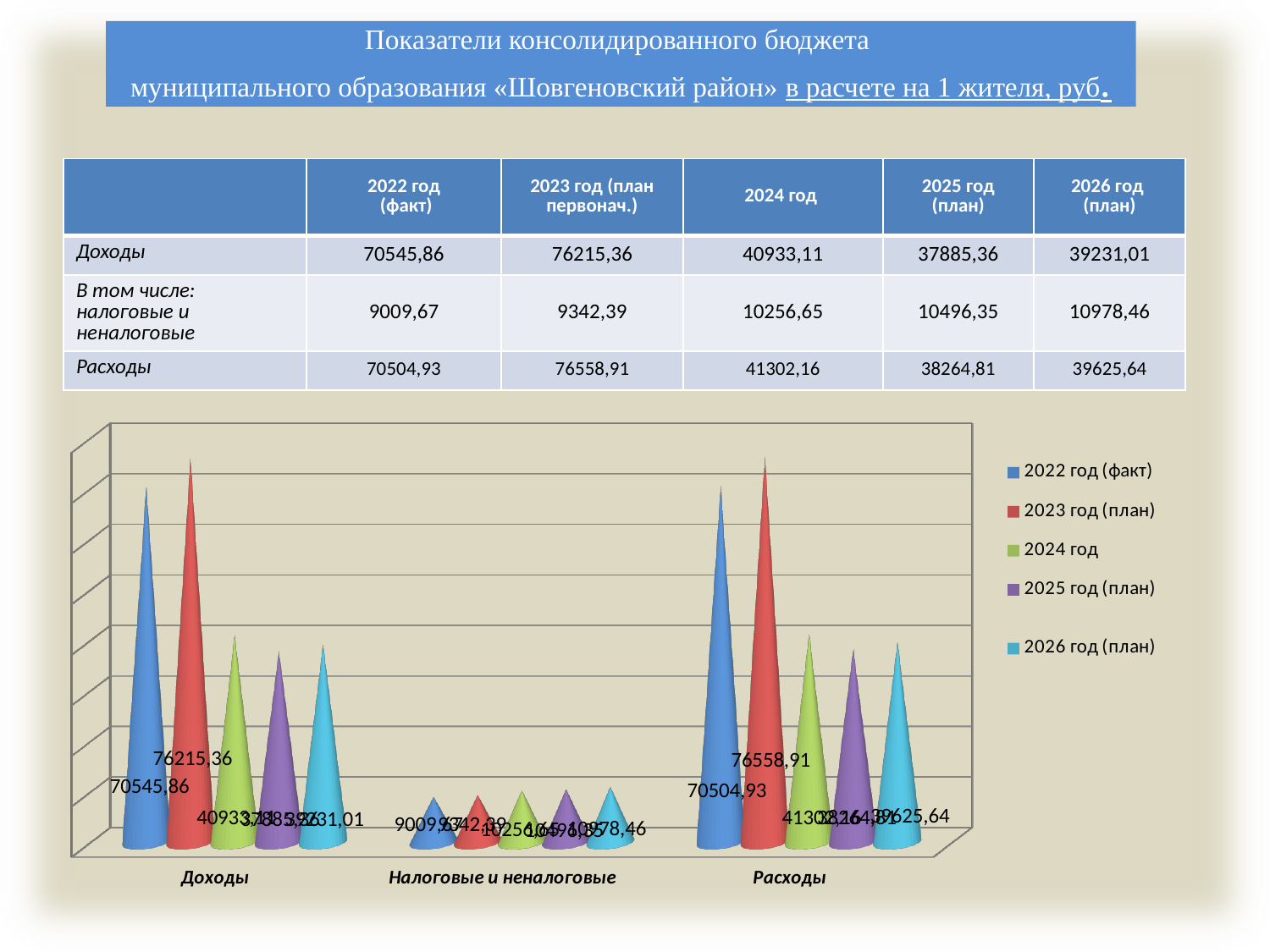
How many categories are shown on the x axis of the chart? 3 What is the value for Доходы in the 2022 год (факт) series? 70545,86 Which colour represents the 2024 год series in the chart? Green What kind of chart is shown on the slide? 3D bar chart Which category has the lowest values across all series? Налоговые и неналоговые What is the value for Расходы in the 2022 год (факт) series? 70504,93 Which series has the highest value for Доходы? 2023 год (план) Which is larger for the 2022 год (факт) series: Доходы or Расходы? Доходы What is the value for Доходы in the 2023 год (план) series? 76215,36 What is the value for Расходы in the 2023 год (план) series? 76558,91 What is the difference between the 2023 год (план) and 2022 год (факт) values for Расходы? 6053,98 How many series does the chart legend list? 5